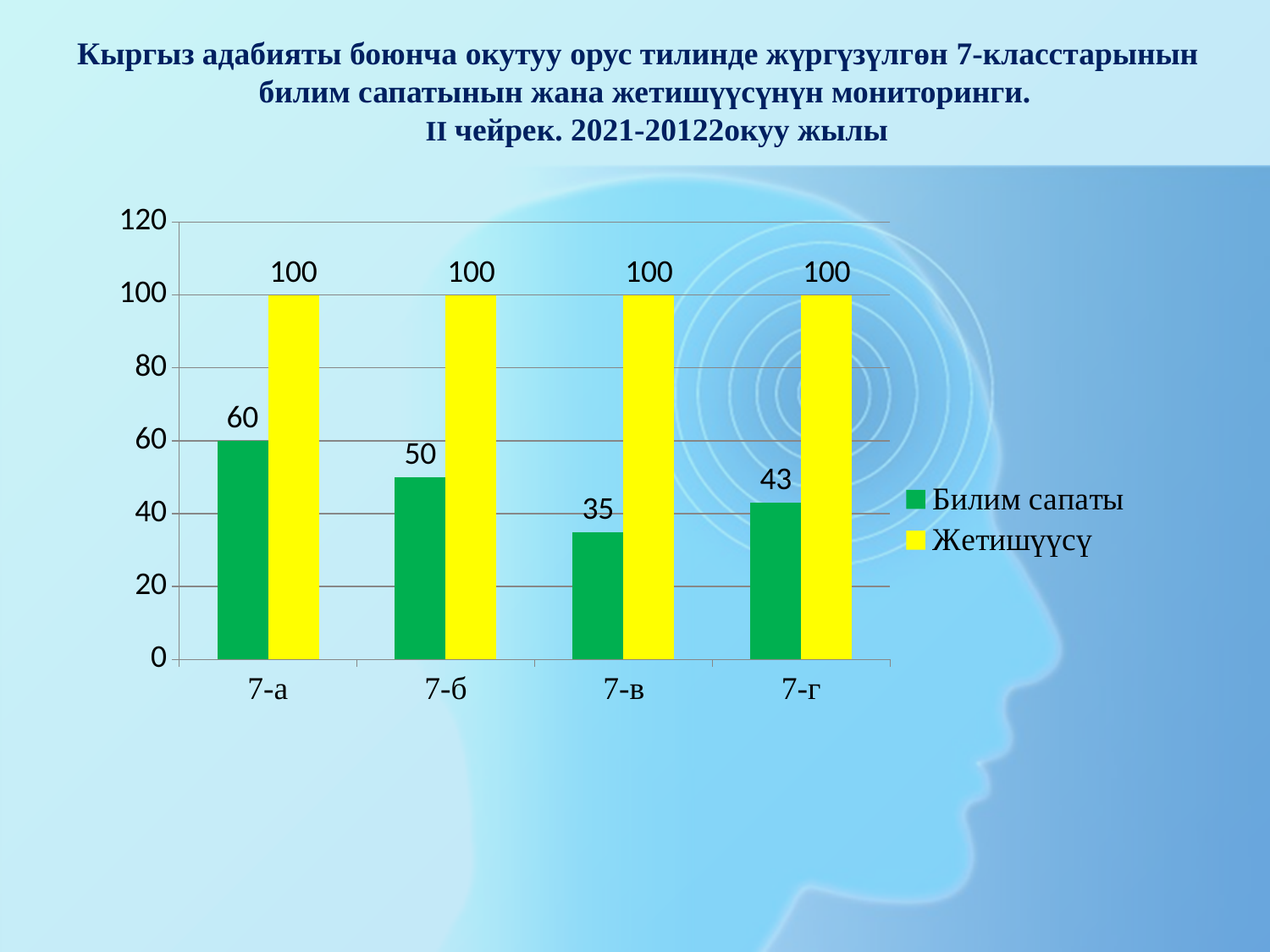
What is the difference between Жетишүүсү and Билим сапаты for class 7-г? 57 What kind of chart is shown on the slide? bar chart What is the value of Жетишүүсү for class 7-г? 100 Which class has the lowest Билим сапаты value? 7-в How many classes are shown on the x axis? 4 Which colour represents Жетишүүсү in the chart? yellow What is the value of Билим сапаты for class 7-в? 35 What is the difference between the Билим сапаты values for 7-а and 7-б? 10 What is the value of Билим сапаты for class 7-а? 60 How many series does the legend list? 2 Which class has the highest Билим сапаты value? 7-а Which is larger, the Билим сапаты value for 7-б or for 7-г? 7-б